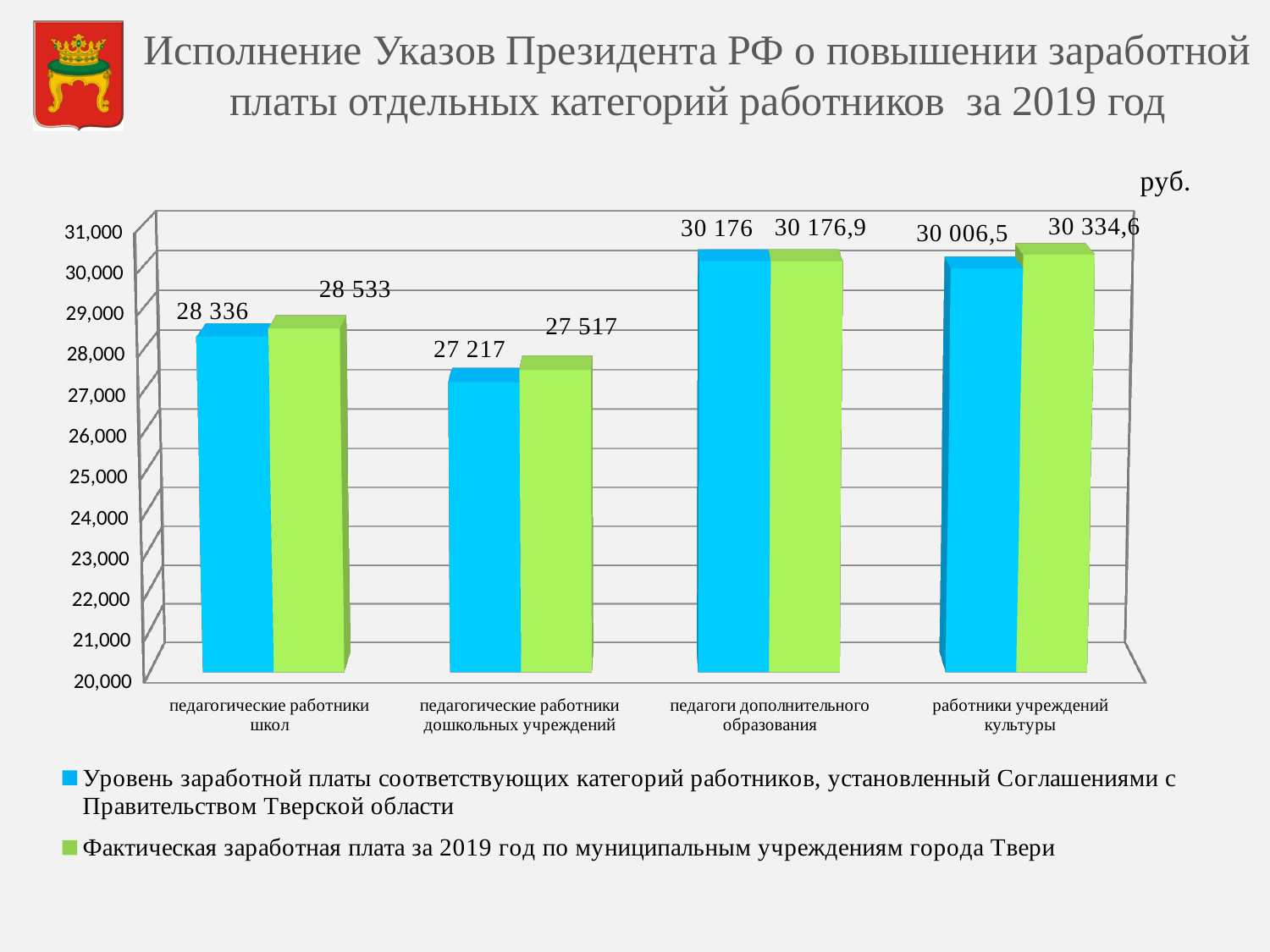
Which category has the highest actual 2019 salary (green series)? работники учреждений культуры How many categories of workers are shown on the x axis? 4 What is the difference between the actual 2019 salary and the agreement-set level for работники учреждений культуры? 328,1 Which category has the lowest agreement-set salary level (blue series)? педагогические работники дошкольных учреждений What is the difference between the actual 2019 salary and the agreement-set level for педагогические работники дошкольных учреждений? 300 What kind of chart is shown on the slide? bar chart How many series does the legend list? 2 What is the value of the agreement-set salary level (blue series) for педагогические работники школ? 28 336 For работники учреждений культуры, which is larger: the agreement-set level or the actual 2019 salary? the actual 2019 salary What is the actual 2019 salary (green series) for работники учреждений культуры? 30 334,6 What is the agreement-set salary level (blue series) for педагоги дополнительного образования? 30 176 What is the actual 2019 salary (green series) for педагогические работники дошкольных учреждений? 27 517